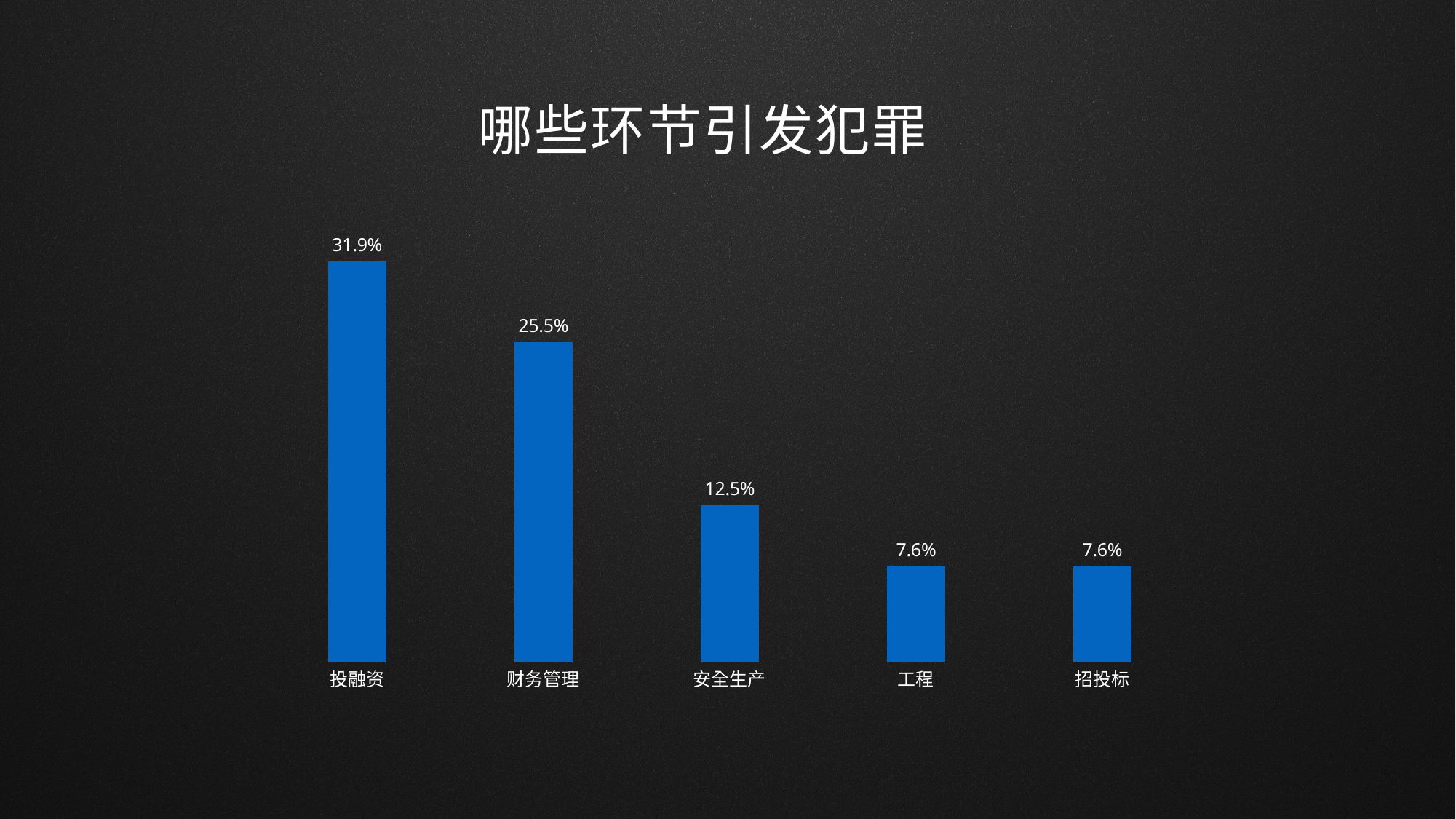
Do the values rise or fall from left to right across the categories? fall What is the value for 投融资? 31.9% Which is larger, the value for 安全生产 or the value for 招投标? 安全生产 What is the difference between the values for 财务管理 and 安全生产? 13.0% Which category has the highest value? 投融资 What is the difference between the values for 投融资 and 财务管理? 6.4% What is the title of the slide? 哪些环节引发犯罪 What is the value for 财务管理? 25.5% What is the value for 安全生产? 12.5% How many categories are shown in the chart? 5 What kind of chart is shown on the slide? bar chart What is the value for 工程? 7.6%